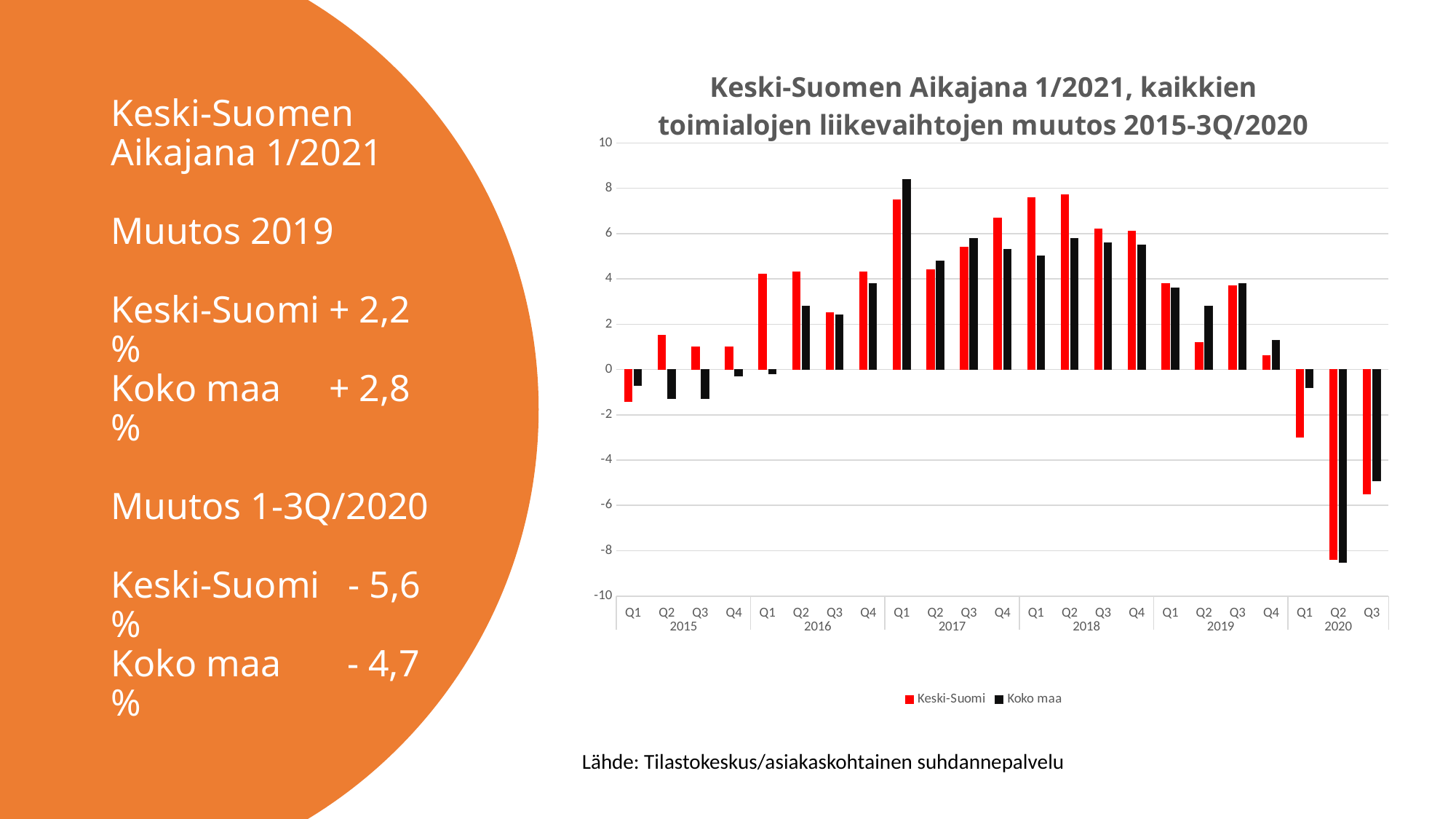
What kind of chart is shown on the slide? Bar chart How many series does the chart legend list? 2 Which colour represents the Koko maa series in the chart? Black Is the Koko maa value for Q1 2020 greater or less than -2? greater In Q2 2018, which series has the larger value, Keski-Suomi or Koko maa? Keski-Suomi Is the Koko maa value for Q3 2020 greater or less than -4? less Is the Koko maa value for Q1 2017 greater or less than 8? greater In which quarter is the Koko maa value highest? Q1 2017 In Q1 2017, which series has the larger value, Keski-Suomi or Koko maa? Koko maa In which quarter is the Keski-Suomi value lowest? Q2 2020 How many quarters are plotted along the x axis of the chart? 23